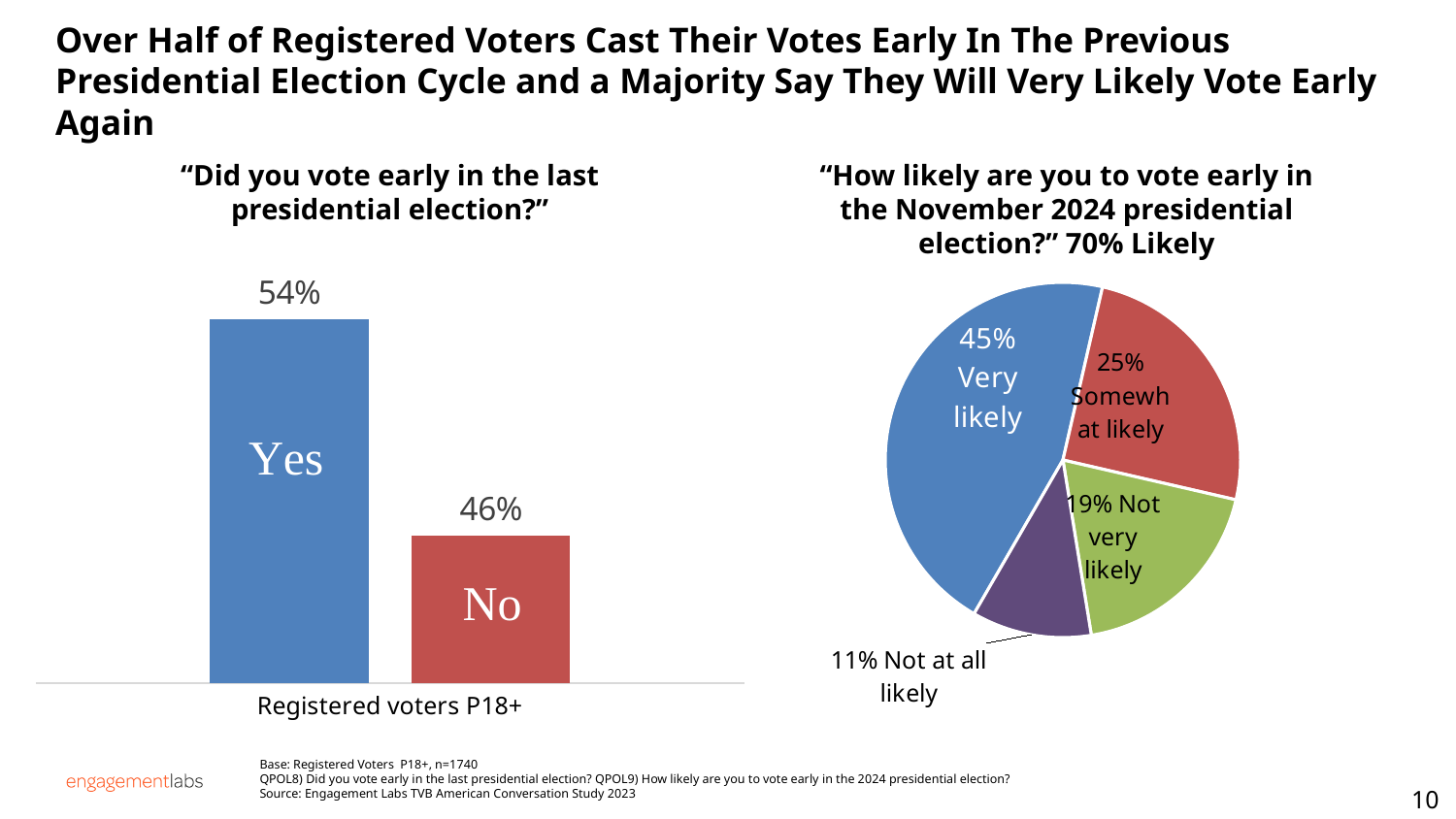
In the bar chart on the left, what is the difference between the Yes and No percentages? 8% In the pie chart on the right, what share is Somewhat likely? 25% In the bar chart "Did you vote early in the last presidential election?", what percentage answered No? 46% How many slices does the pie chart on the right have? 4 What type of chart is shown on the left side of the slide? Bar chart In the pie chart on the right, which category has the largest slice? Very likely What type of chart is shown on the right side of the slide? Pie chart In the bar chart "Did you vote early in the last presidential election?", what percentage answered Yes? 54% In the pie chart on the right, which category has the smallest slice? Not at all likely In the bar chart on the left, which response has the higher value, Yes or No? Yes In the pie chart on the right, what share is Not at all likely? 11% In the pie chart "How likely are you to vote early in the November 2024 presidential election?", what share is Very likely? 45%